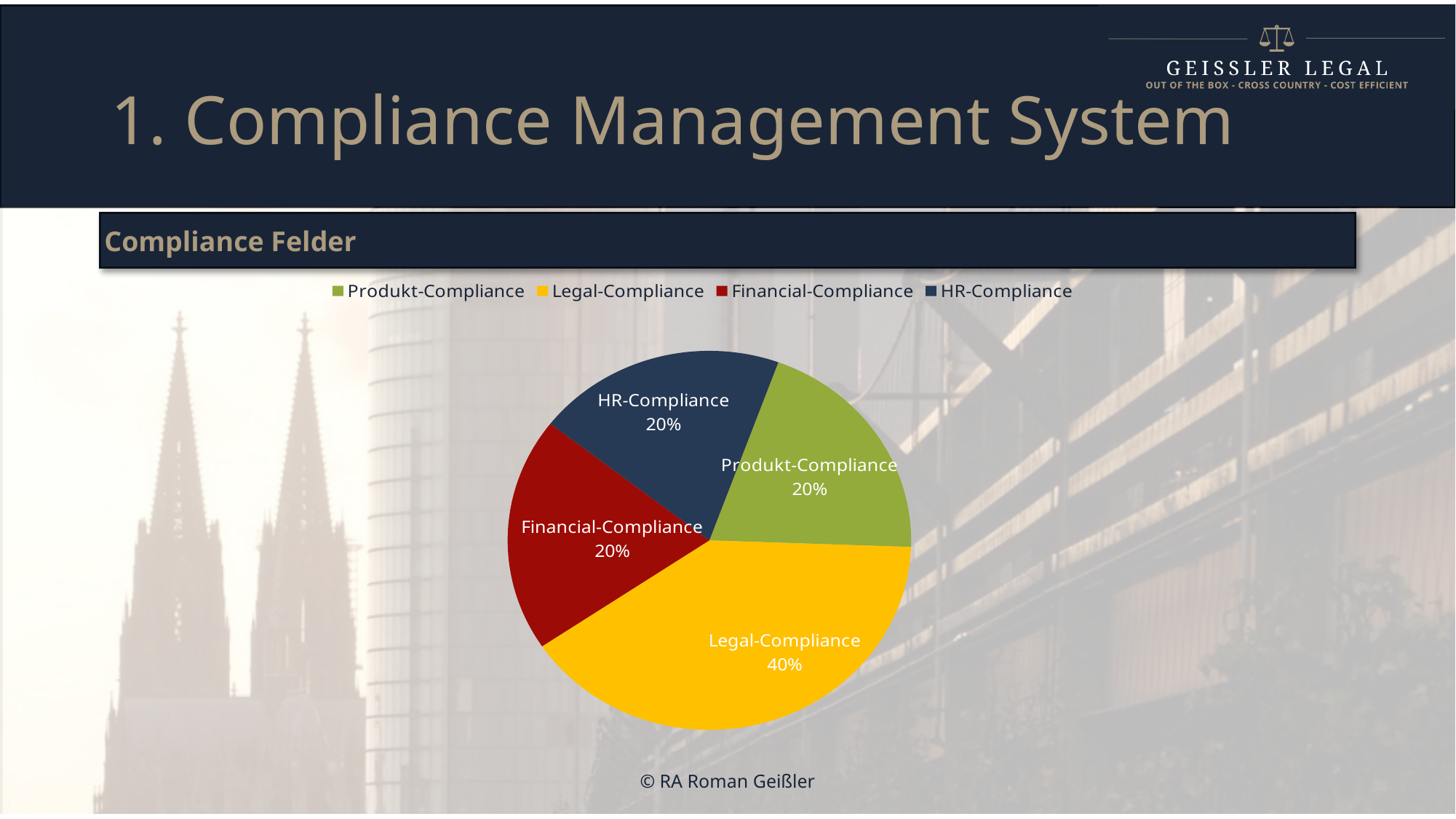
What is the combined share of Produkt-Compliance and Financial-Compliance? 40% Which is larger, the share of Legal-Compliance or the share of Financial-Compliance? Legal-Compliance How many entries does the legend list? 4 Which category has the largest slice of the pie? Legal-Compliance What share of the pie does Financial-Compliance have? 20% What share of the pie does Produkt-Compliance have? 20% What kind of chart is shown on the slide? pie chart How many slices does the pie chart have? 4 What colour is the Legal-Compliance slice? yellow What share of the pie does Legal-Compliance have? 40% What is the difference between the shares of Legal-Compliance and HR-Compliance? 20%